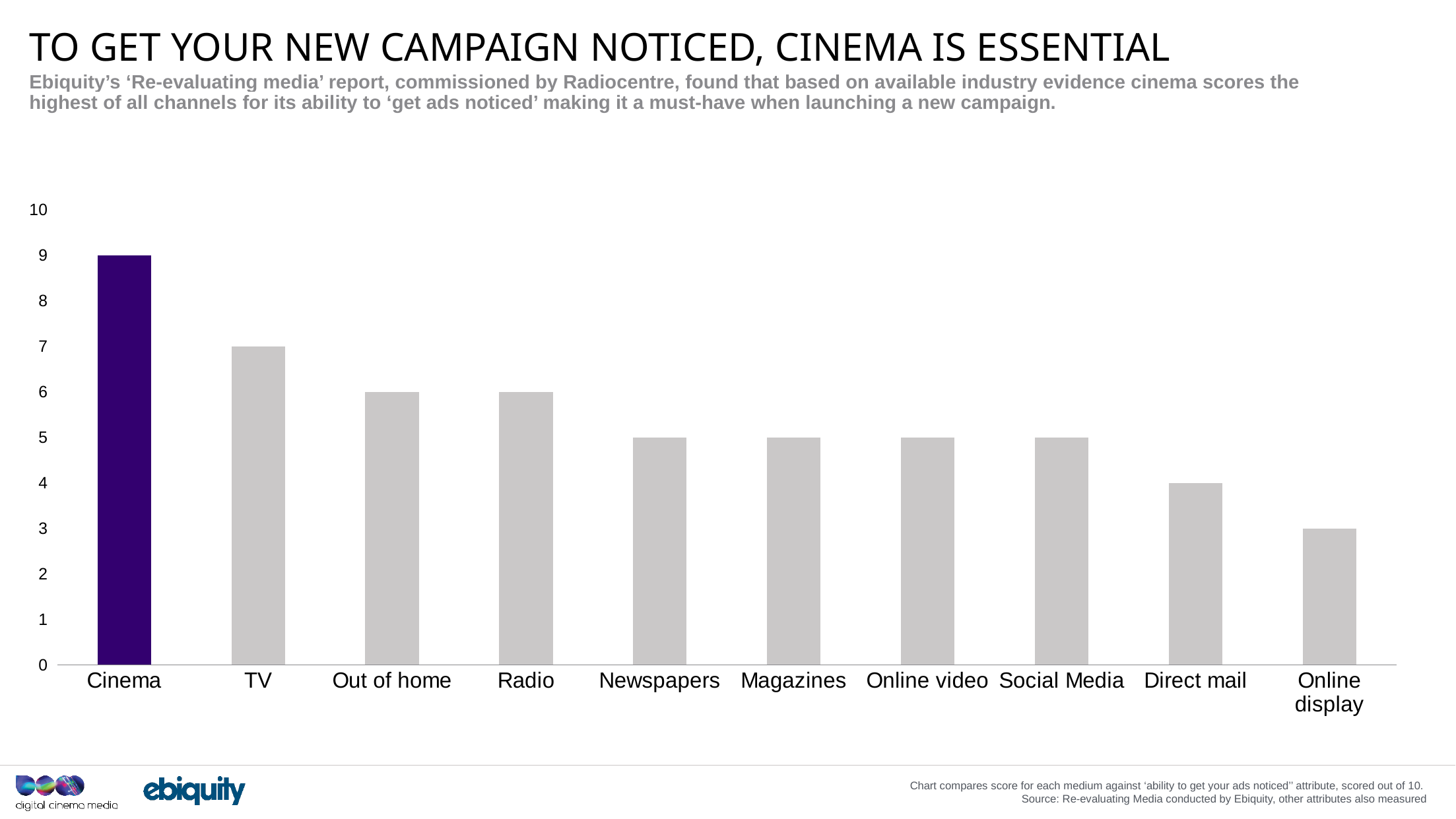
Is the value for Radio greater or less than 5? greater Which medium has the highest score on the chart? Cinema Which has a higher score, Out of home or Newspapers? Out of home Which medium has the lowest score on the chart? Online display What score does Online display have on the chart? 3 What is the difference between the scores for Cinema and TV? 2 What score does Cinema have on the chart? 9 What score does TV have on the chart? 7 What kind of chart is shown on the slide? Bar chart Which bar is coloured differently from the others on the chart? Cinema What score does Direct mail have on the chart? 4 How many media are shown on the chart? 10